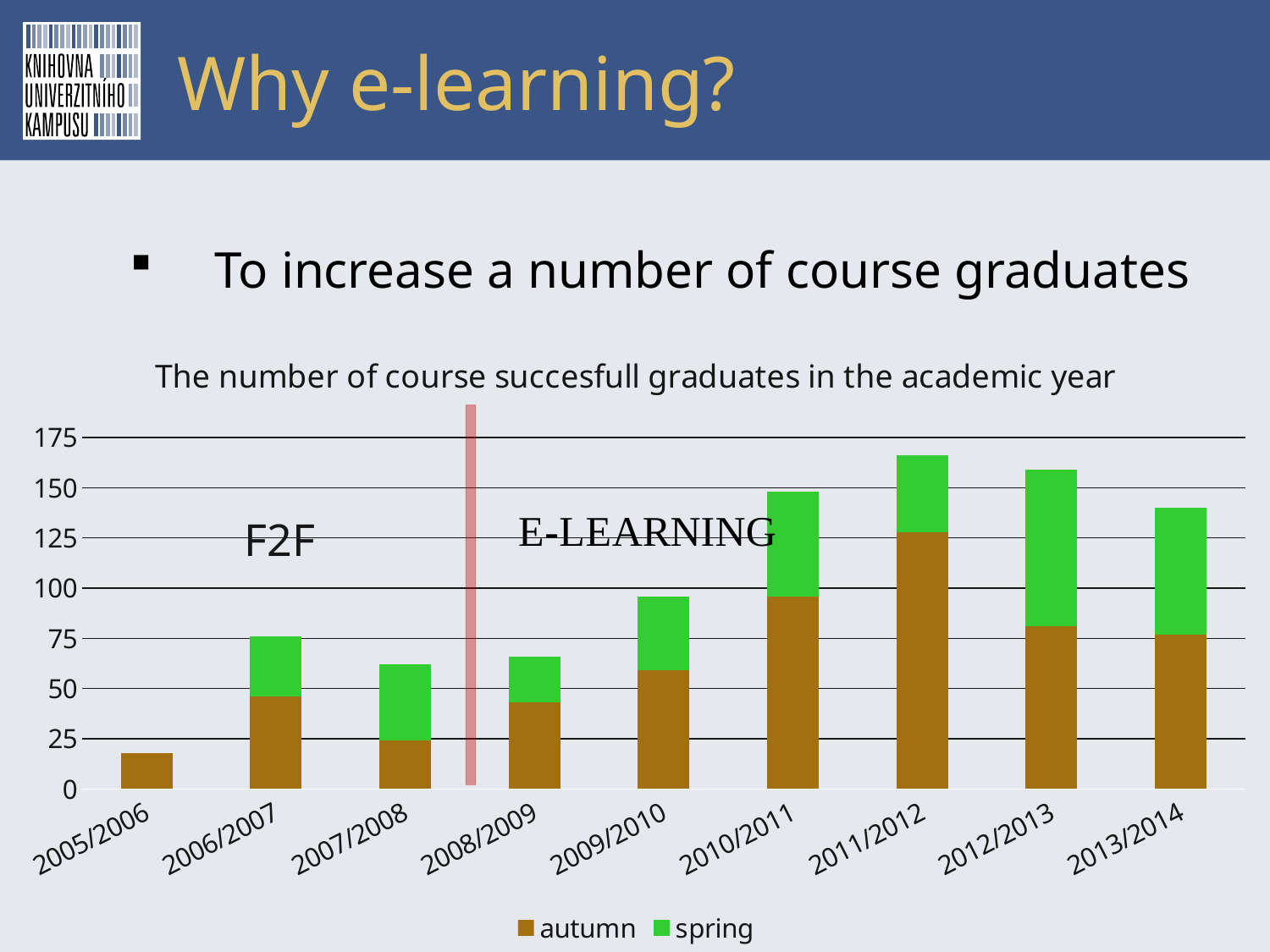
What kind of chart is shown on the slide? Stacked bar chart Which academic year has the highest total number of graduates? 2011/2012 Is the total value for 2005/2006 greater or less than 25? less How many academic years are shown on the x axis of the chart? 9 What is the title of the chart? The number of course succesfull graduates in the academic year Which academic year has the lowest total number of graduates? 2005/2006 Which has a larger total number of graduates, 2012/2013 or 2013/2014? 2012/2013 Is the total value for 2011/2012 greater or less than 150? greater Do the total numbers of graduates rise or fall from 2008/2009 to 2011/2012? rise Is the total value for 2013/2014 greater or less than 125? greater How many series does the chart legend list? 2